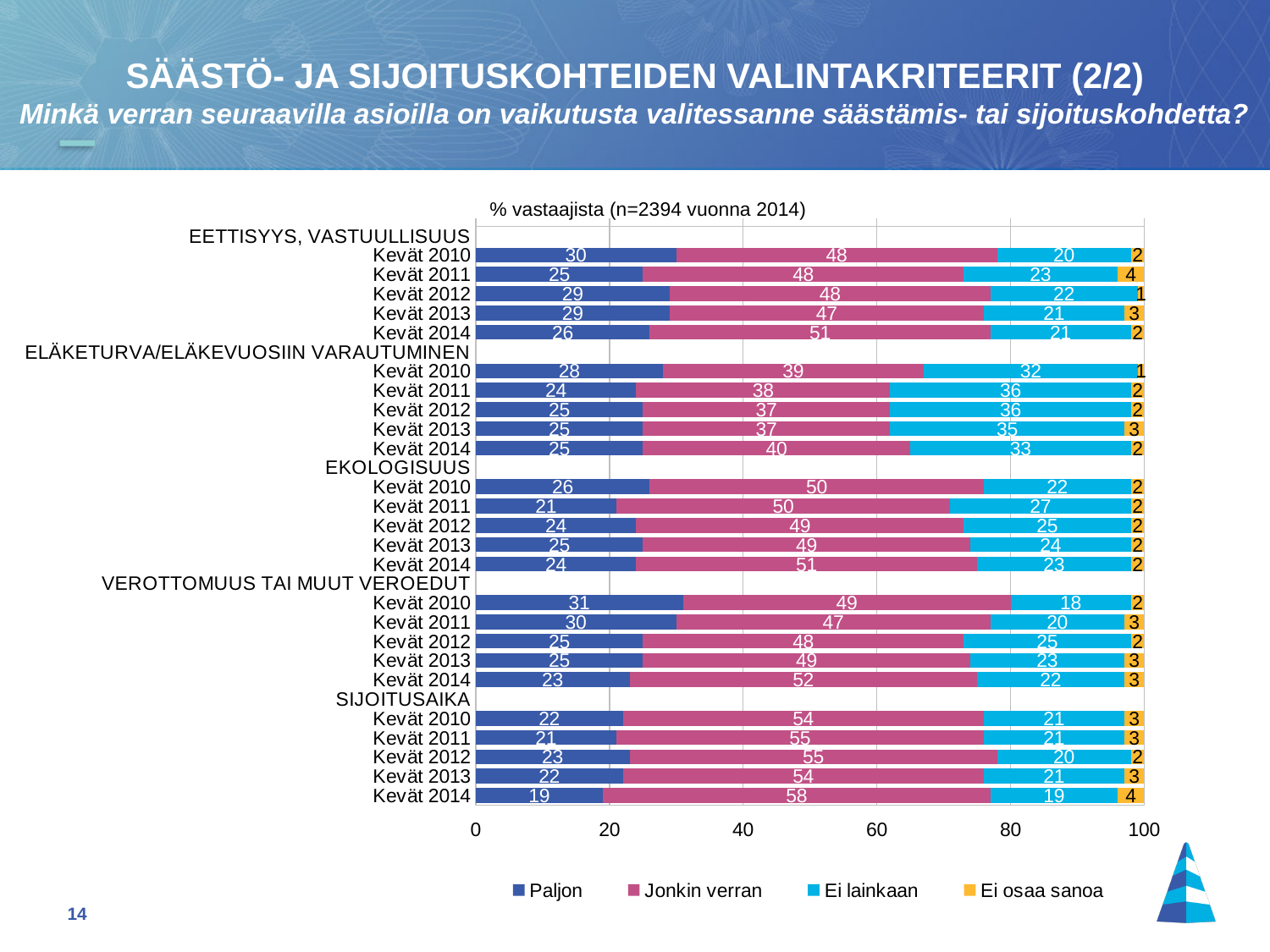
What is the "Ei osaa sanoa" value for Kevät 2011 under EETTISYYS, VASTUULLISUUS? 4 Within the EETTISYYS, VASTUULLISUUS group, which year has the lowest "Paljon" value? Kevät 2011 What is the difference between the "Jonkin verran" values for Kevät 2014 and Kevät 2010 under SIJOITUSAIKA? 4 What is the "Paljon" value for Kevät 2014 under SIJOITUSAIKA? 19 Within the SIJOITUSAIKA group, which year has the highest "Jonkin verran" value? Kevät 2014 Within the VEROTTOMUUS TAI MUUT VEROEDUT group, which year has the highest "Paljon" value? Kevät 2010 How many series does the legend list? 4 What is the "Jonkin verran" value for Kevät 2010 under ELÄKETURVA/ELÄKEVUOSIIN VARAUTUMINEN? 39 Which is larger: the "Ei lainkaan" value for Kevät 2011 under ELÄKETURVA/ELÄKEVUOSIIN VARAUTUMINEN or the "Ei lainkaan" value for Kevät 2011 under EKOLOGISUUS? ELÄKETURVA/ELÄKEVUOSIIN VARAUTUMINEN Kevät 2011 What kind of chart is shown on the slide? Stacked bar chart What is the total of the Kevät 2014 bar under EETTISYYS, VASTUULLISUUS? 100 What is the "Ei lainkaan" value for Kevät 2011 under EKOLOGISUUS? 27